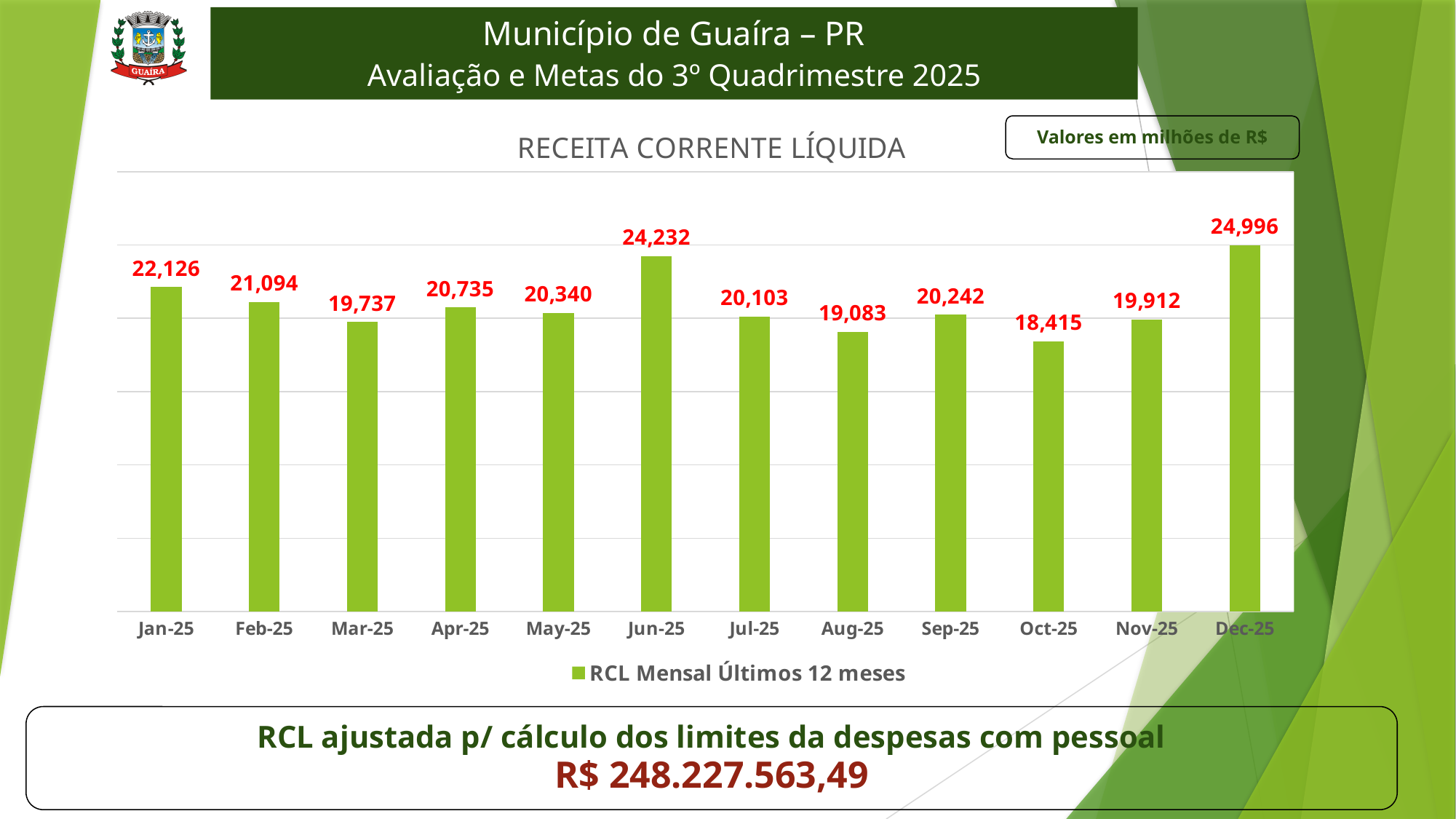
What is the value for Oct-25? 18,415 What is the series name shown in the chart legend? RCL Mensal Últimos 12 meses How many months are plotted on the chart? 12 What is the value for Mar-25? 19,737 Which month has the lowest value? Oct-25 Which month has the highest value? Dec-25 Which is larger, the value for Sep-25 or the value for Aug-25? Sep-25 What is the difference between the values for Jun-25 and Jul-25? 4,129 Between Jun-25 and Aug-25, do the values rise or fall? fall What type of chart is shown on the slide? bar chart What is the value for Jun-25? 24,232 Which is larger, the value for Jan-25 or the value for Feb-25? Jan-25